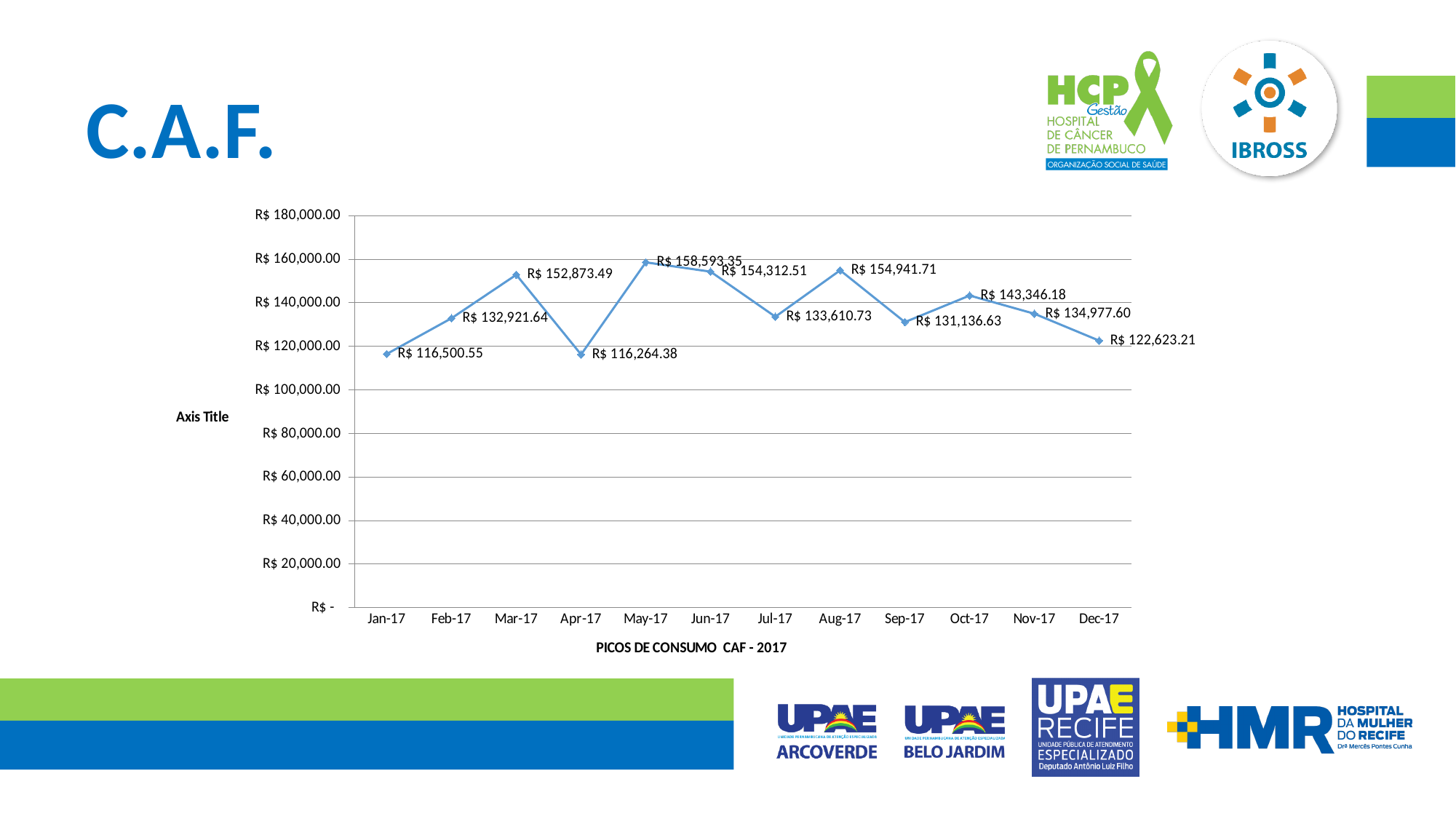
What is the value for Jan-17? R$ 116,500.55 What is the value for Oct-17? R$ 143,346.18 Is the value for Sep-17 greater or less than R$ 140,000.00? less Which is larger, the value for Aug-17 or the value for Jul-17? Aug-17 How many months are plotted on the chart? 12 What is the value for May-17? R$ 158,593.35 Which month has the lowest value? Apr-17 What is the title shown below the chart? PICOS DE CONSUMO CAF - 2017 Do the values rise or fall from Oct-17 to Dec-17? fall What is the difference between the values for May-17 and Apr-17? R$ 42,328.97 Which month has the highest value? May-17 What type of chart is shown on the slide? Line chart